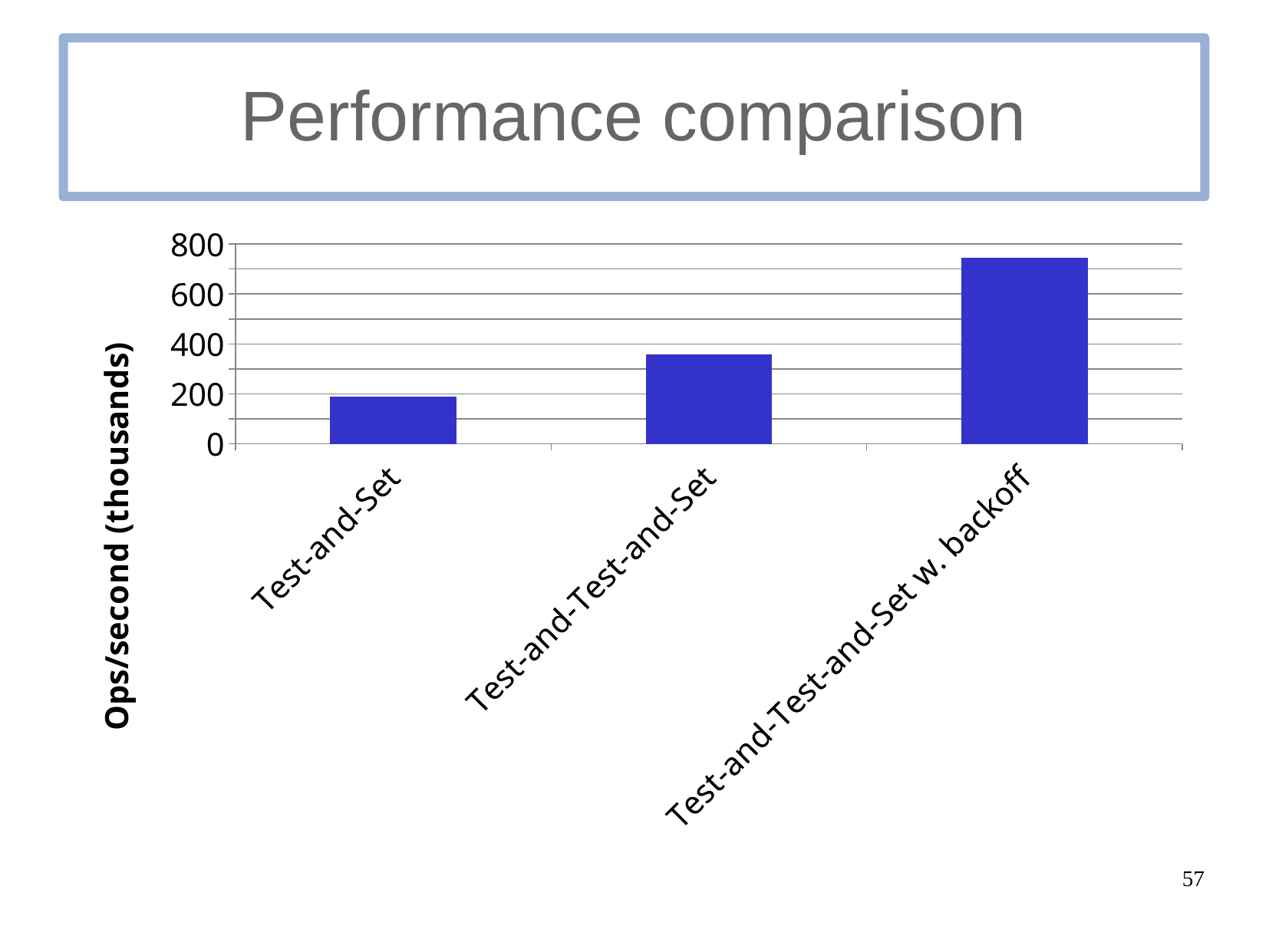
Which category has the highest value? Test-and-Test-and-Set w. backoff How many categories are plotted in the chart? 3 What is the title of the slide containing the chart? Performance comparison What is the label of the vertical axis? Ops/second (thousands) Which category has the lowest value? Test-and-Set Is the value for Test-and-Test-and-Set greater or less than 400? less Do the values rise or fall from left to right along the x axis? rise What kind of chart is shown on the slide? bar chart Is the value for Test-and-Test-and-Set greater or less than 200? greater Is the value for Test-and-Test-and-Set w. backoff greater or less than 600? greater Which is larger, the value for Test-and-Set or the value for Test-and-Test-and-Set? Test-and-Test-and-Set